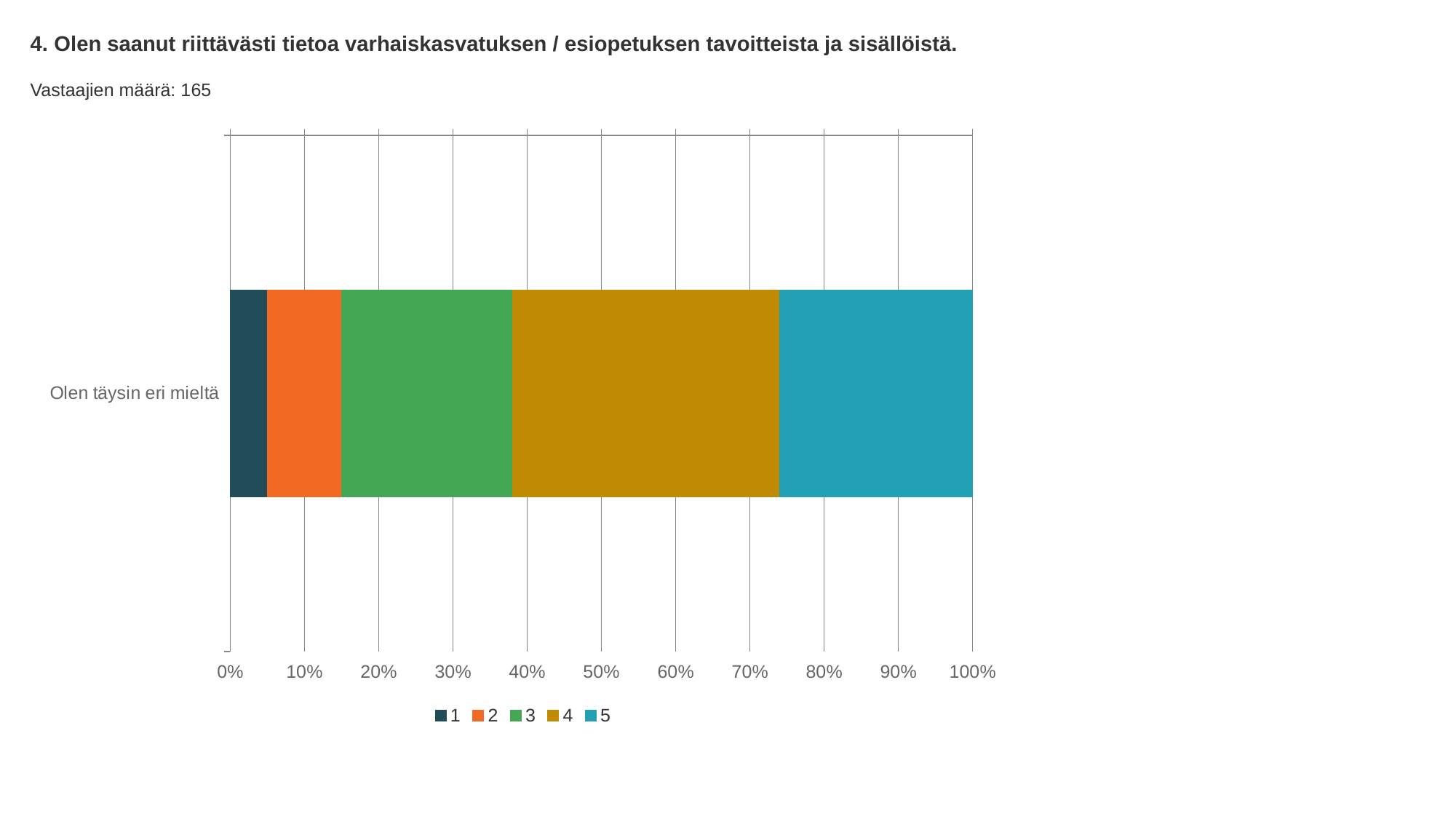
Which series has the largest segment in the bar? 4 How many respondents (Vastaajien määrä) are reported on the slide? 165 What is the total of the stacked bar as shown on the x axis? 100% How many categories are plotted on the y axis? 1 Which segment is larger, series 4 or series 5? 4 Which segment is larger, series 2 or series 3? 3 Which series has the smallest segment in the bar? 1 What kind of chart is shown on the slide? Stacked bar chart How many series does the legend list? 5 Is the share for series 4 greater or less than 30%? greater Is the share for series 1 greater or less than 10%? less Is the share for series 5 greater or less than 20%? greater